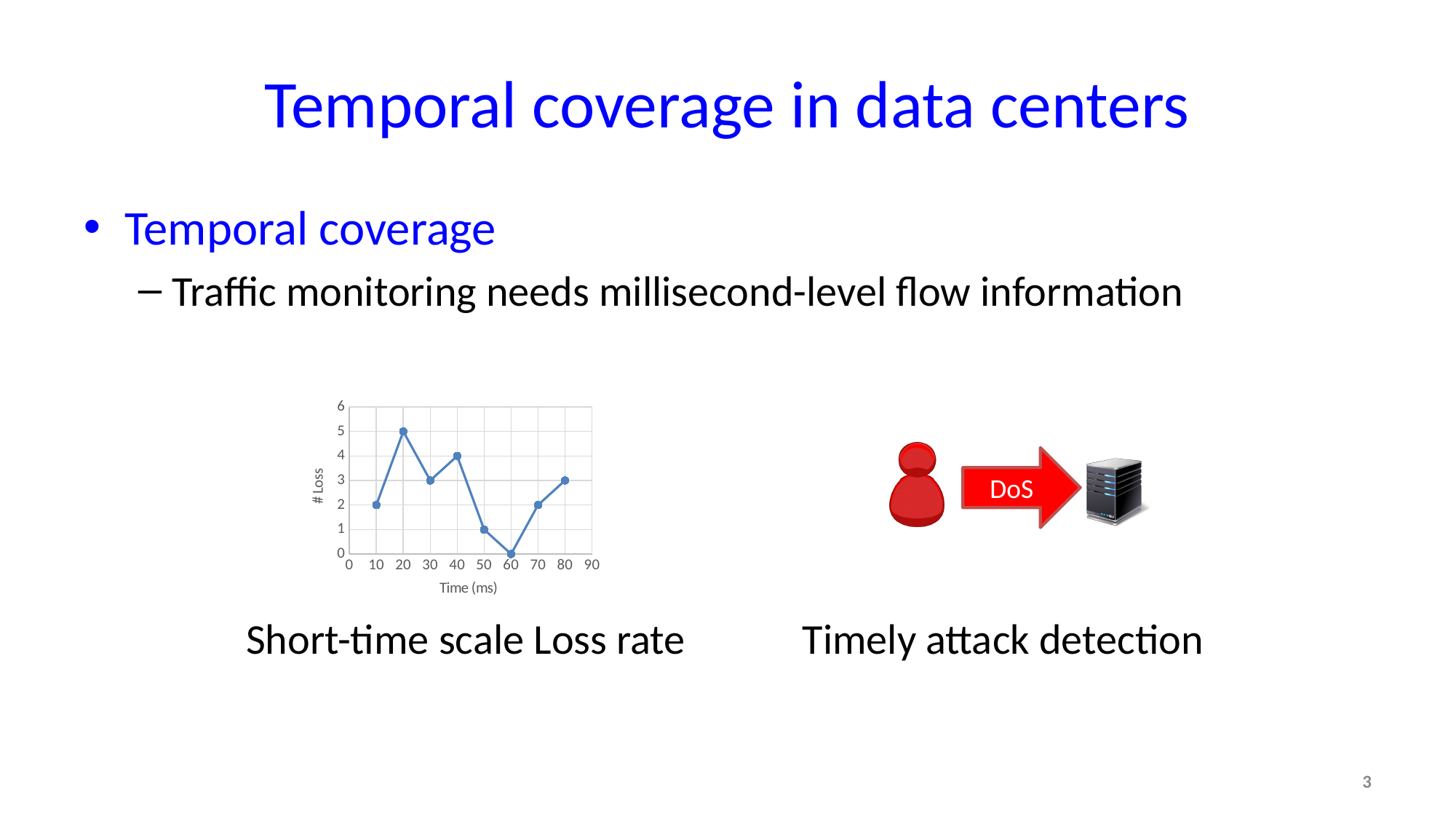
Does the # Loss rise or fall from 60 ms to 80 ms? rise What is the difference in # Loss between 20 ms and 30 ms? 2 What is the # Loss value at 60 ms? 0 What type of chart is shown on the slide? line chart What is the # Loss value at 40 ms? 4 What is the label of the x axis of the chart? Time (ms) How many data points are plotted on the line chart? 8 What is the label of the y axis of the chart? # Loss What is the # Loss value at 20 ms? 5 At which time (ms) is the # Loss highest? 20 Which has a higher # Loss, 40 ms or 50 ms? 40 ms At which time (ms) is the # Loss lowest? 60